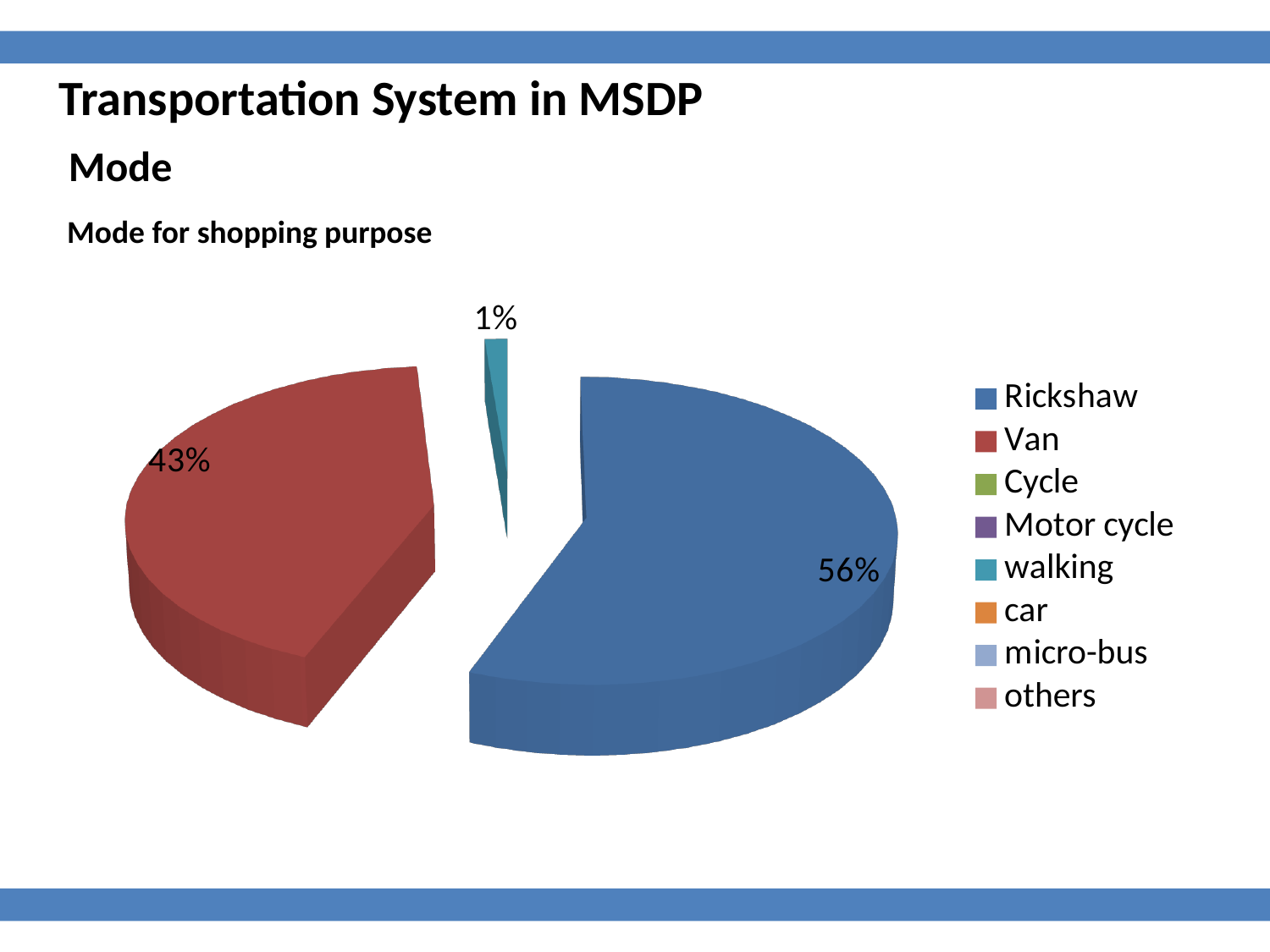
What percentage is shown for walking? 1% Which mode has the largest share of the pie? Rickshaw What kind of chart is shown on the slide? Pie chart What share of the pie does Rickshaw account for? 56% How many percentage points larger is the Rickshaw share than the Van share? 13 Which is larger, the share for Van or the share for walking? Van How many entries does the legend list? 8 What percentage is shown for Van? 43% How many slices of the pie have a percentage label? 3 What is the combined share of Rickshaw and Van? 99% Which of the labeled slices has the smallest share? walking What is the title of the chart? Mode for shopping purpose